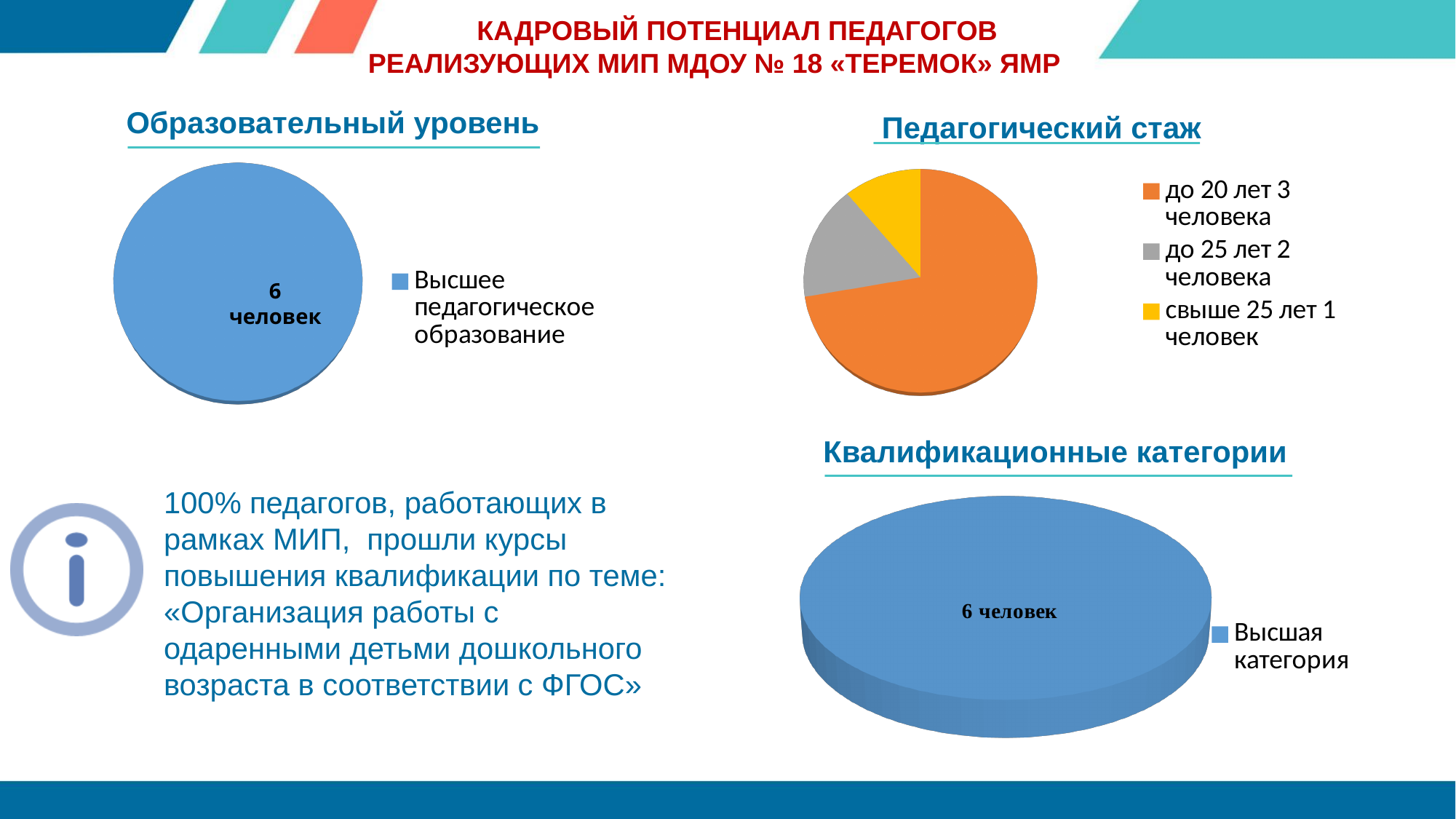
In the "Педагогический стаж" chart, which category has the largest slice? до 20 лет In the "Образовательный уровень" chart, how many people are shown for "Высшее педагогическое образование"? 6 человек In the "Квалификационные категории" chart, what is the legend entry for the single slice? Высшая категория How many slices does the "Педагогический стаж" pie chart have? 3 In the "Педагогический стаж" chart, what is the total number of people across all categories? 6 In the "Педагогический стаж" chart, how many people are in the "до 20 лет" category? 3 человека What kind of chart is the "Образовательный уровень" chart? pie chart In the "Педагогический стаж" chart, which is larger: "до 25 лет" or "свыше 25 лет"? до 25 лет In the "Педагогический стаж" chart, how many people are in the "свыше 25 лет" category? 1 человек In the "Педагогический стаж" chart, how many more people are in "до 20 лет" than in "до 25 лет"? 1 In the "Педагогический стаж" chart, which category has the smallest slice? свыше 25 лет